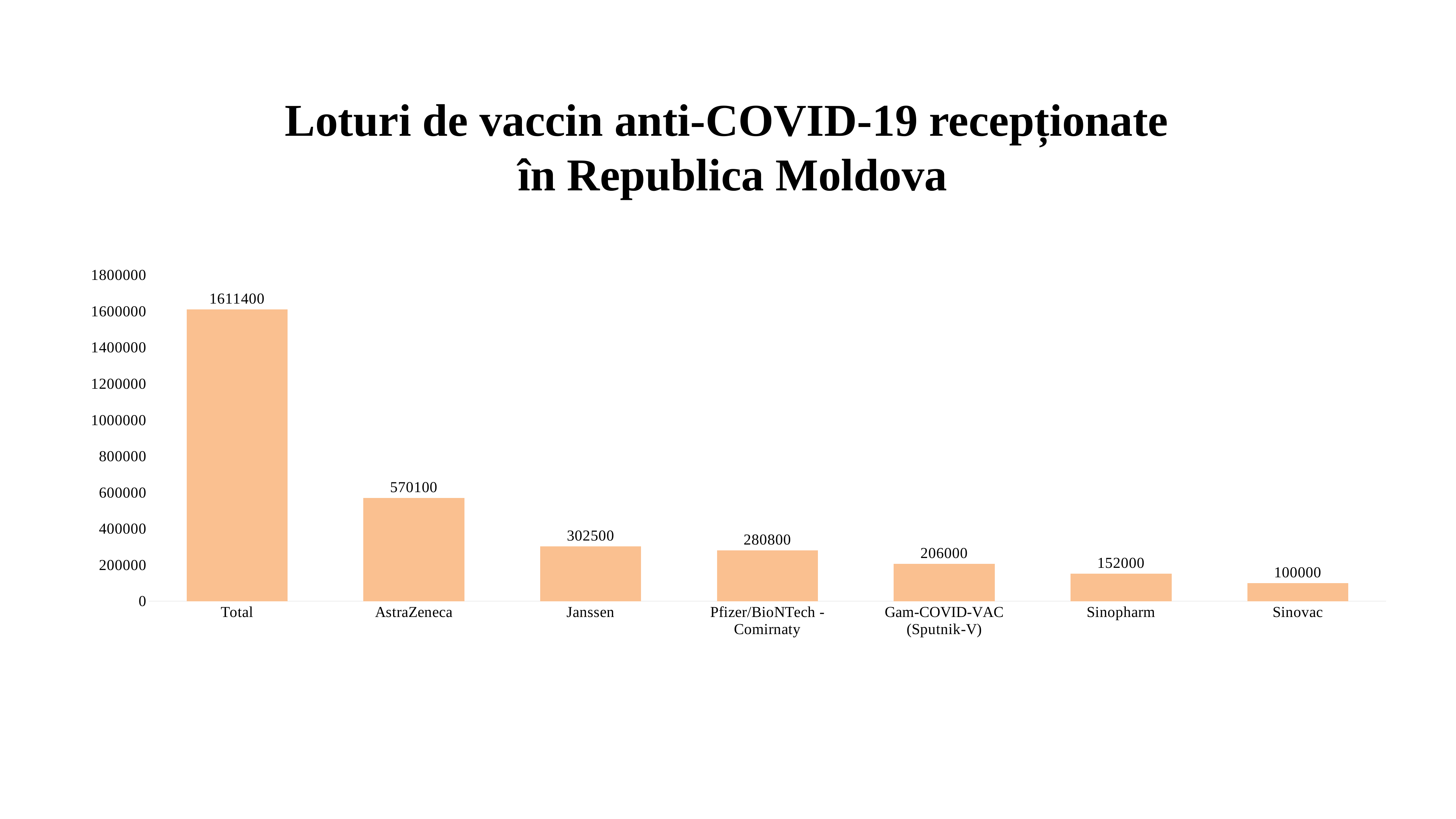
How many categories are shown on the x axis? 7 What is the title of the chart? Loturi de vaccin anti-COVID-19 recepționate în Republica Moldova Which category has the highest value? Total What is the value for Sinovac? 100000 What is the difference between the values for AstraZeneca and Janssen? 267600 What is the value for Janssen? 302500 Which is larger, the value for Pfizer/BioNTech - Comirnaty or the value for Gam-COVID-VAC (Sputnik-V)? Pfizer/BioNTech - Comirnaty Which category has the lowest value? Sinovac What is the value for Gam-COVID-VAC (Sputnik-V)? 206000 What is the value for AstraZeneca? 570100 What kind of chart is shown on the slide? bar chart What is the difference between the values for Sinopharm and Sinovac? 52000